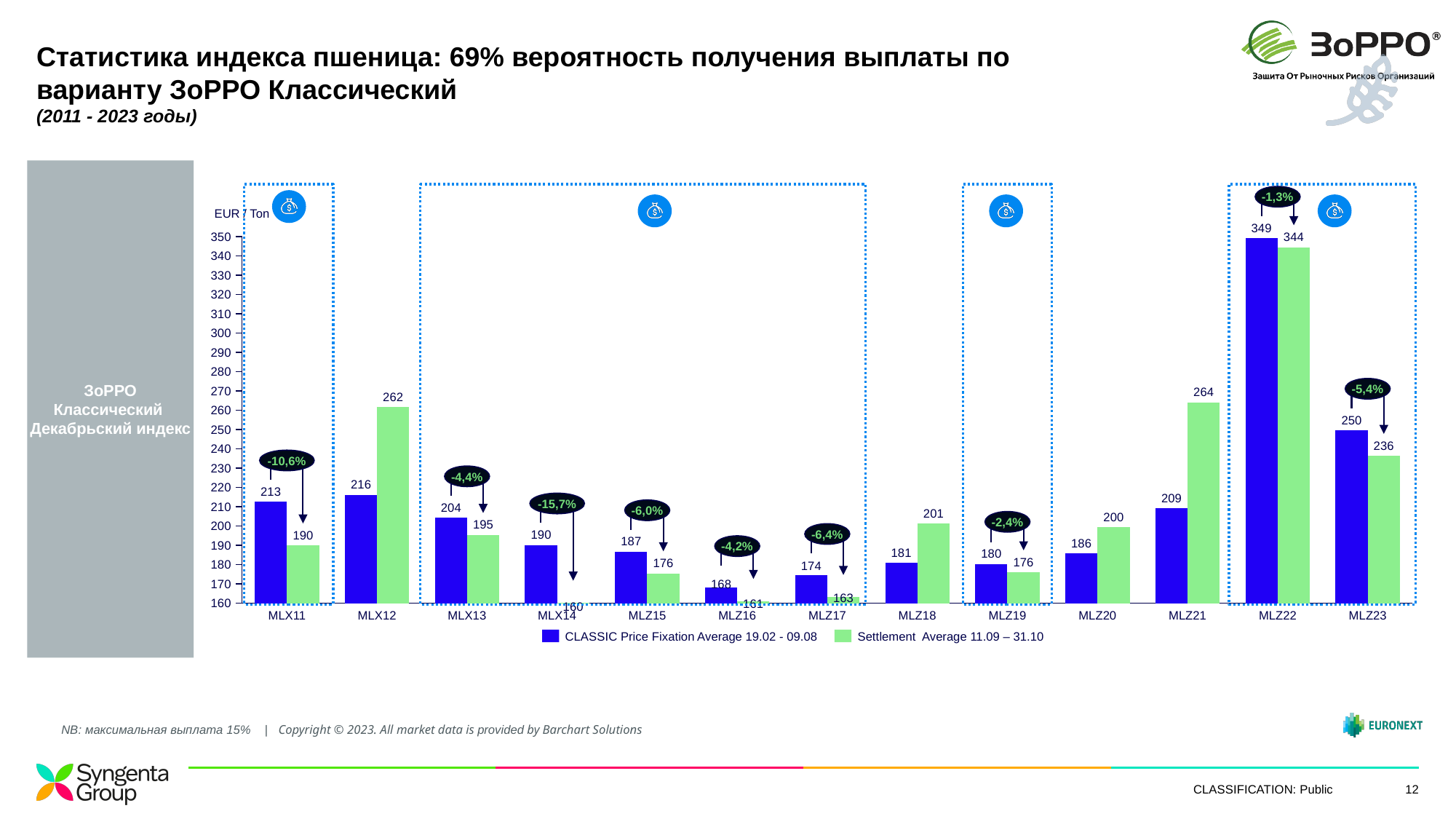
How many series does the legend list? 2 What unit is shown on the y axis of the chart? EUR / Ton Which category has the lowest Settlement Average value? MLX14 What is the Settlement Average value for MLX12? 262 What is the difference between the CLASSIC Price Fixation Average and the Settlement Average for MLX11? 23 What is the CLASSIC Price Fixation Average value for MLZ22? 349 What is the Settlement Average value for MLZ23? 236 Which category has the highest CLASSIC Price Fixation Average value? MLZ22 For MLZ21, which is larger: the CLASSIC Price Fixation Average or the Settlement Average? Settlement Average What kind of chart is shown on the slide? Bar chart How many categories are shown on the x axis? 13 What percentage change is labelled above the MLX14 bars? -15,7%